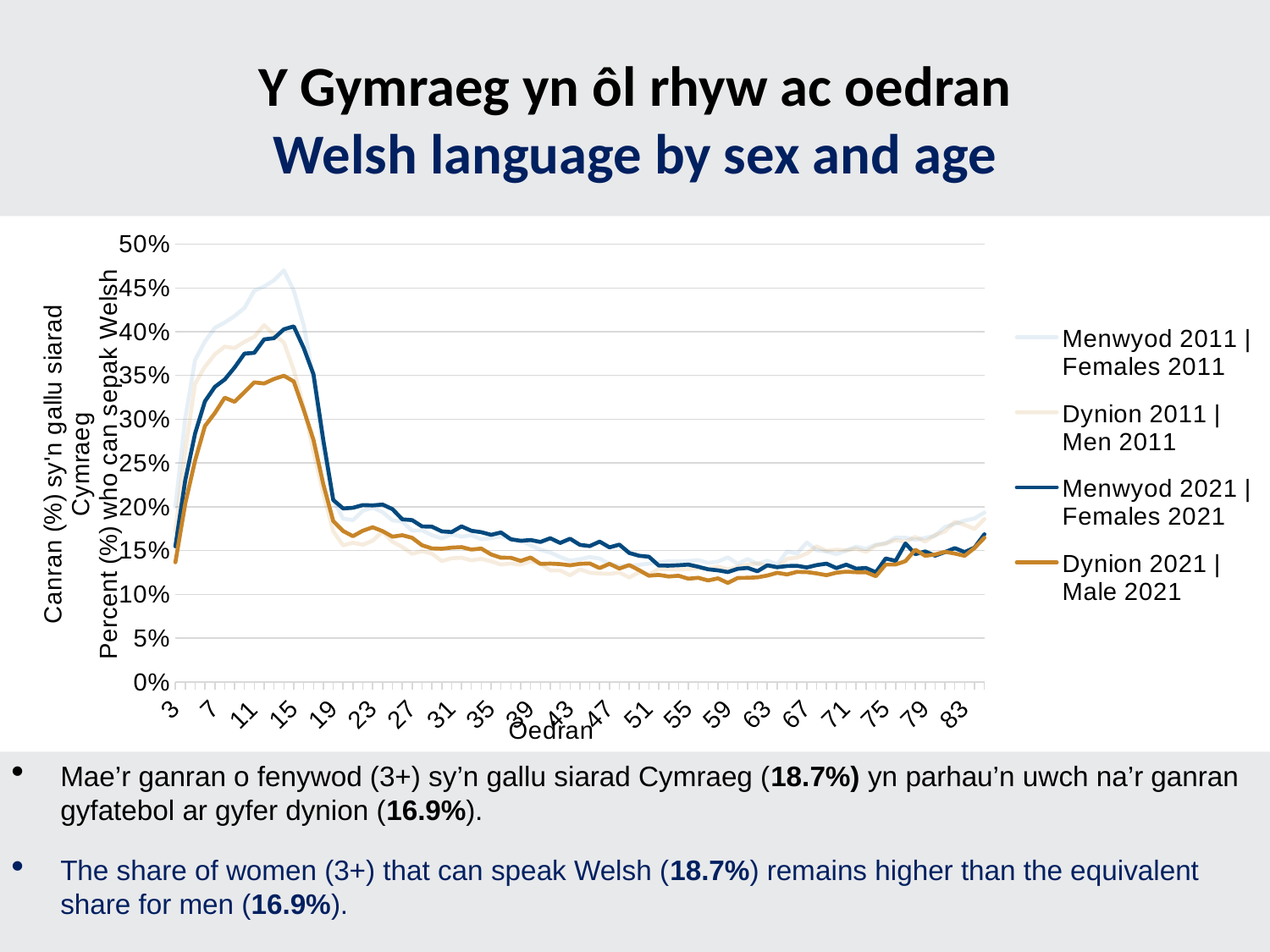
What is the highest value shown on the chart's vertical axis? 50% At age 15, which is higher: Menwyod 2021 | Females 2021 or Dynion 2021 | Male 2021? Menwyod 2021 | Females 2021 Do the values for Dynion 2021 | Male 2021 rise or fall between age 15 and age 19? fall Do the values for Menwyod 2021 | Females 2021 rise or fall between age 3 and age 15? rise Is the value for Dynion 2021 | Male 2021 at age 59 greater or less than 15%? less How many series does the chart's legend list? 4 What kind of chart is shown on the slide? line chart Which series reaches the highest peak value on the chart? Menwyod 2011 | Females 2011 Is the value for Menwyod 2021 | Females 2021 at age 15 greater or less than 35%? greater Is the peak value for Menwyod 2011 | Females 2011 greater or less than 45%? greater What is the title of the chart's horizontal axis? Oedran